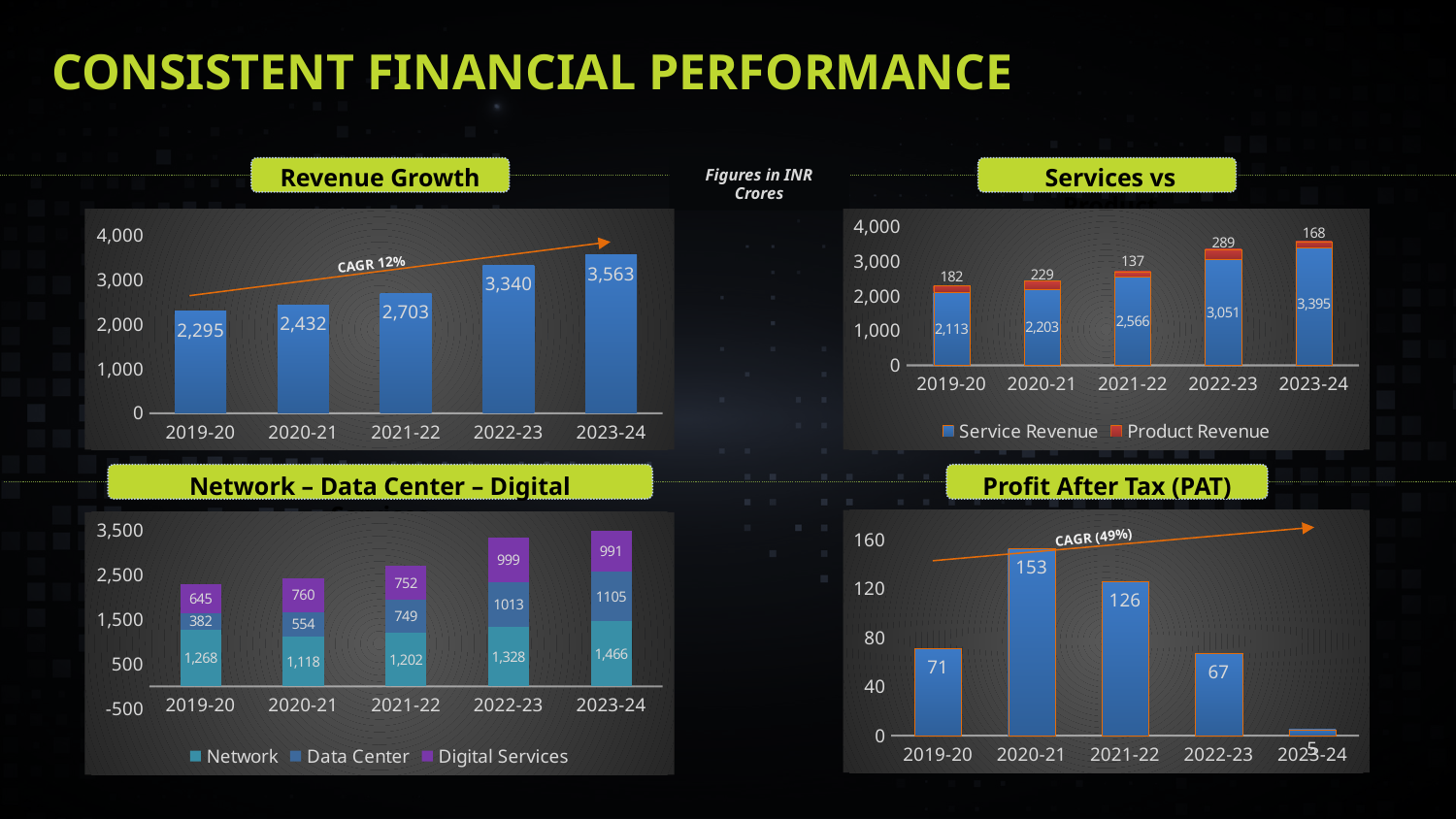
In the Services vs chart, how many series does the legend list? 2 In the Services vs chart, what is the Product Revenue value for 2022-23? 289 In the Revenue Growth chart, what is the difference between the 2023-24 and 2019-20 values? 1,268 In the Revenue Growth chart, what is the value for 2021-22? 2,703 In the Network – Data Center – Digital chart, which series is shown in purple? Digital Services In the Profit After Tax (PAT) chart, which year has the highest value? 2020-21 In the Services vs chart, what is the Service Revenue value for 2021-22? 2,566 In the Profit After Tax (PAT) chart, is the value for 2021-22 larger than the value for 2022-23? Yes In the Network – Data Center – Digital chart, what is the Data Center value for 2020-21? 554 In the Revenue Growth chart, which year has the highest revenue? 2023-24 In the Services vs chart, what is the total of the stacked bar for 2023-24? 3,563 In the Revenue Growth chart, do the values rise or fall from 2019-20 to 2023-24? rise